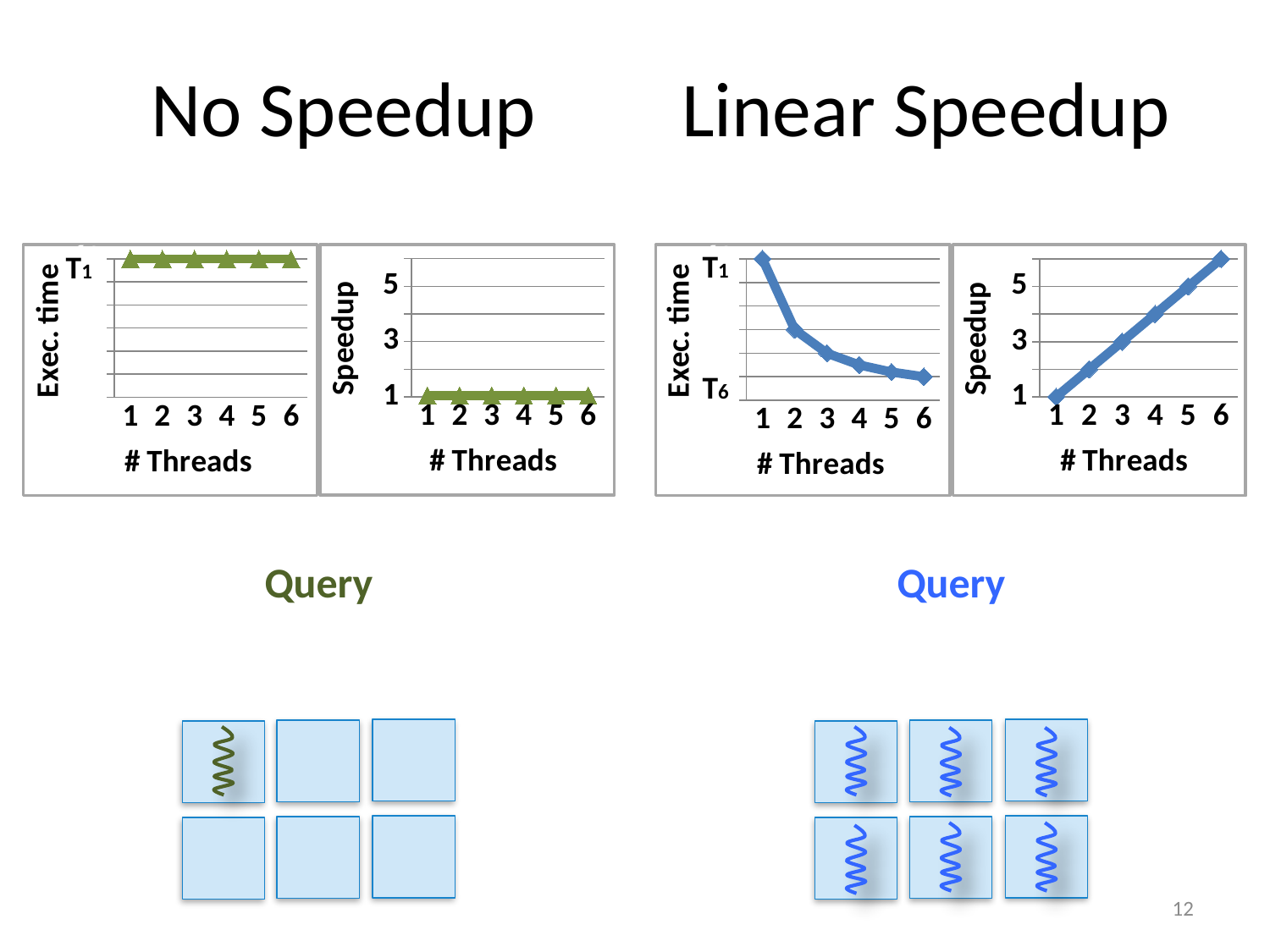
In the Speedup chart under "Linear Speedup", what is the speedup at 3 threads? 3 What kind of chart is the Speedup chart under the "Linear Speedup" heading? line chart In the Speedup chart under "Linear Speedup", what is the speedup at 5 threads? 5 In the Exec. time chart under "Linear Speedup", which thread count has the highest execution time? 1 In the Speedup chart under "Linear Speedup", do the values rise or fall as the number of threads increases? rise In the Exec. time chart under "Linear Speedup", do the values rise or fall as the number of threads increases? fall In the Speedup chart under "No Speedup", do the values rise, fall, or stay flat as the number of threads increases? stay flat What is the x-axis label on the Exec. time chart under "No Speedup"? # Threads In the Speedup chart under "Linear Speedup", what is the speedup at 1 thread? 1 In the Speedup chart under "Linear Speedup", is the speedup at 6 threads greater or less than 5? greater In the Speedup chart under "Linear Speedup", how many thread counts are plotted on the x axis? 6